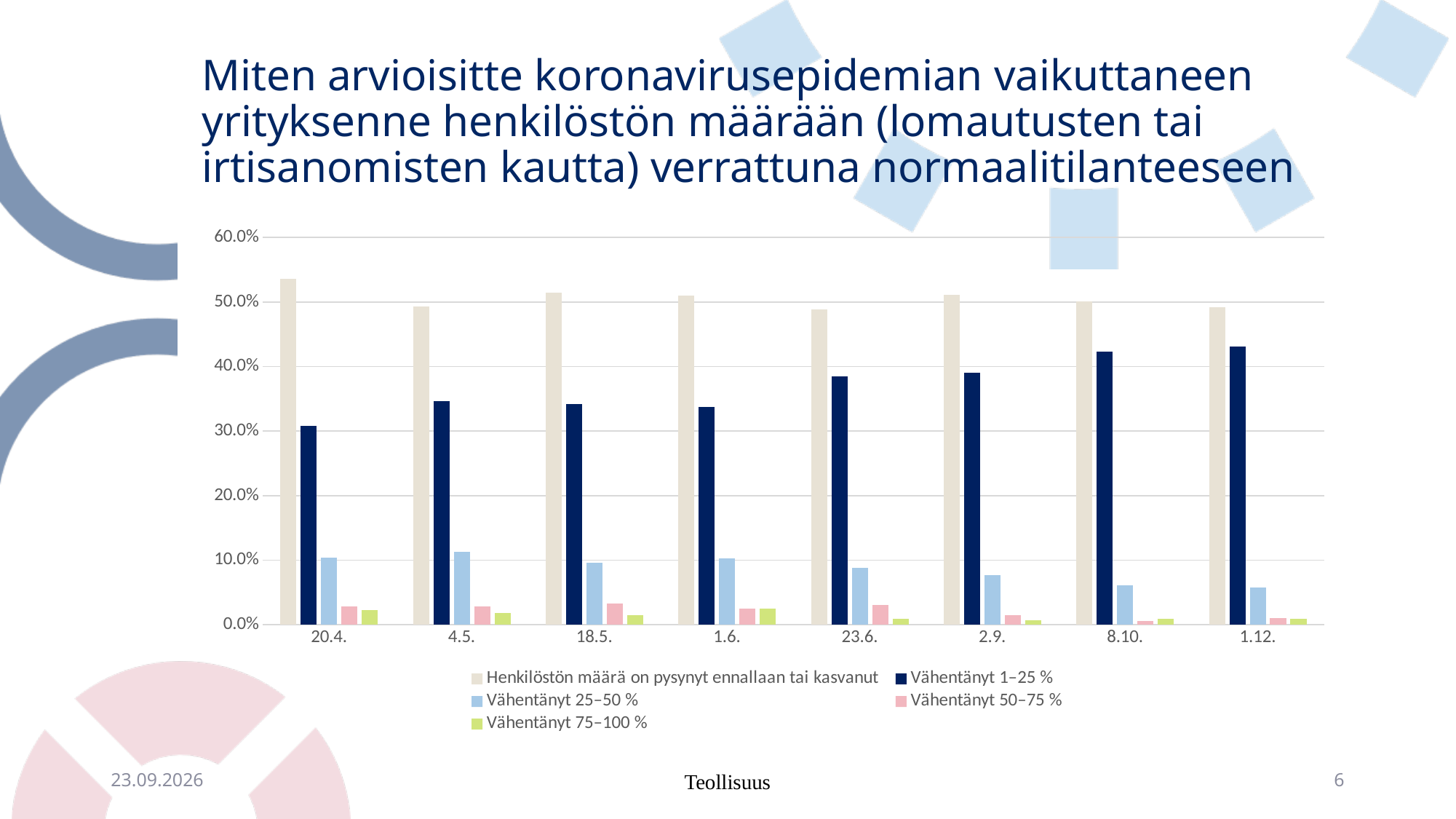
Is the value for 'Henkilöstön määrä on pysynyt ennallaan tai kasvanut' on 20.4. greater or less than 50.0%? greater Does the value for 'Vähentänyt 25–50 %' generally rise or fall from 20.4. to 1.12.? fall On 20.4., which is larger: 'Henkilöstön määrä on pysynyt ennallaan tai kasvanut' or 'Vähentänyt 1–25 %'? Henkilöstön määrä on pysynyt ennallaan tai kasvanut How many dates are shown on the x axis of the chart? 8 On which date is the value for 'Henkilöstön määrä on pysynyt ennallaan tai kasvanut' highest? 20.4. Is the value for 'Vähentänyt 25–50 %' on 4.5. greater or less than 10.0%? greater On which date is the value for 'Vähentänyt 1–25 %' lowest? 20.4. Is the value for 'Vähentänyt 1–25 %' on 8.10. greater or less than 40.0%? greater What colour represents 'Vähentänyt 75–100 %' in the legend? green What kind of chart is shown on the slide? bar chart How many series does the chart's legend list? 5